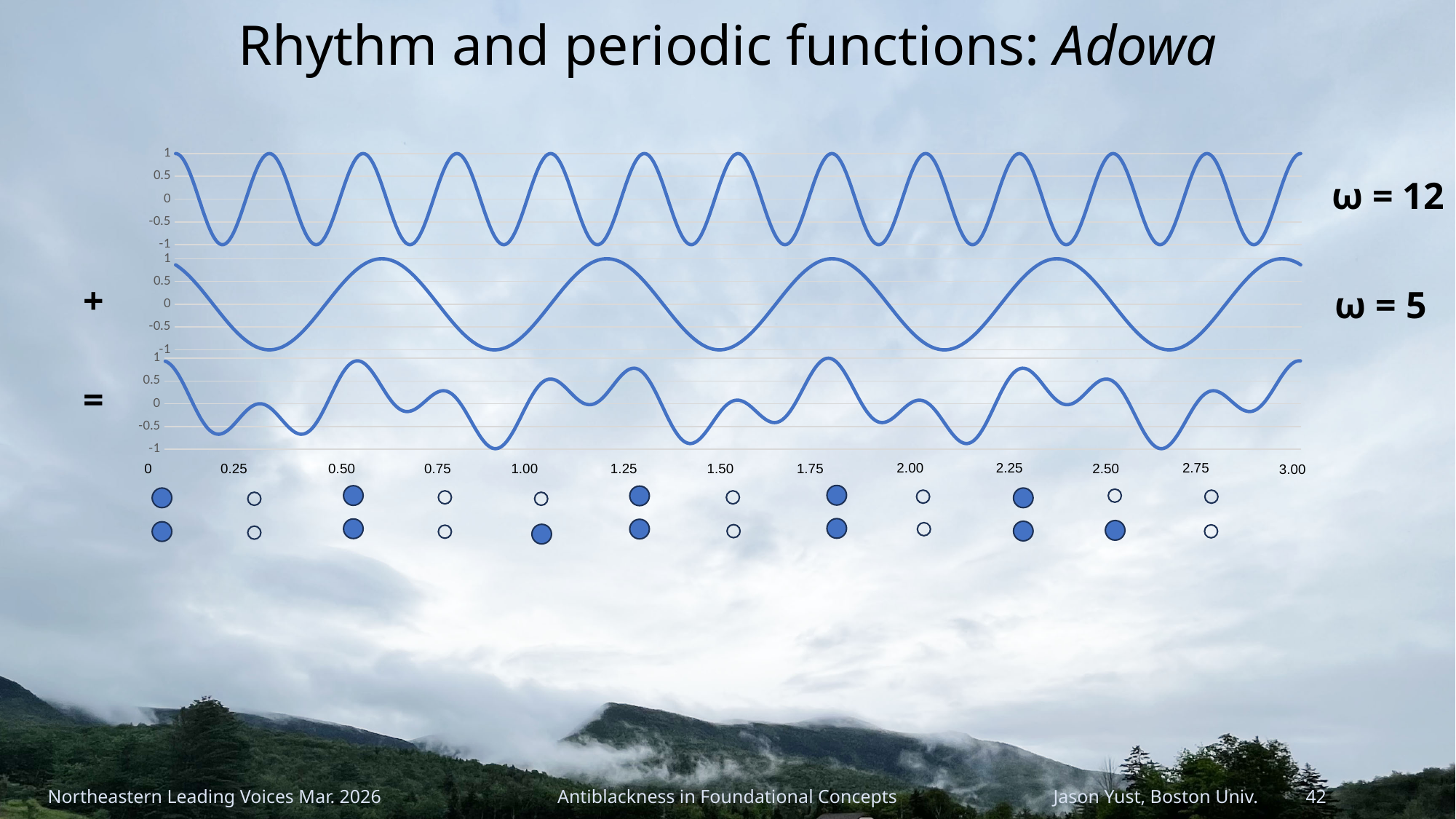
In the middle chart (ω = 5), how many troughs (minima) does the wave have between x = 0 and x = 3.00? 5 What is the highest value shown on the y axis of the top chart? 1 What is the label to the right of the top chart? ω = 12 How many charts are stacked on the slide? 3 In the top chart (ω = 12), how many troughs (minima) does the wave have between x = 0 and x = 3.00? 12 In the top chart (ω = 12), what is the value of the wave at x = 0? 1 In the middle chart (ω = 5), is the value of the wave at x = 0.25 greater or less than 0? less In the bottom chart (the sum), is the value of the wave at x = 1.00 greater or less than 0? greater What is the label to the right of the middle chart? ω = 5 What kind of chart is the top chart labelled ω = 12? line chart What is the largest x-axis tick label shown below the bottom chart? 3.00 In the bottom chart (the sum), is the value of the wave at x = 0 greater or less than 0.5? greater